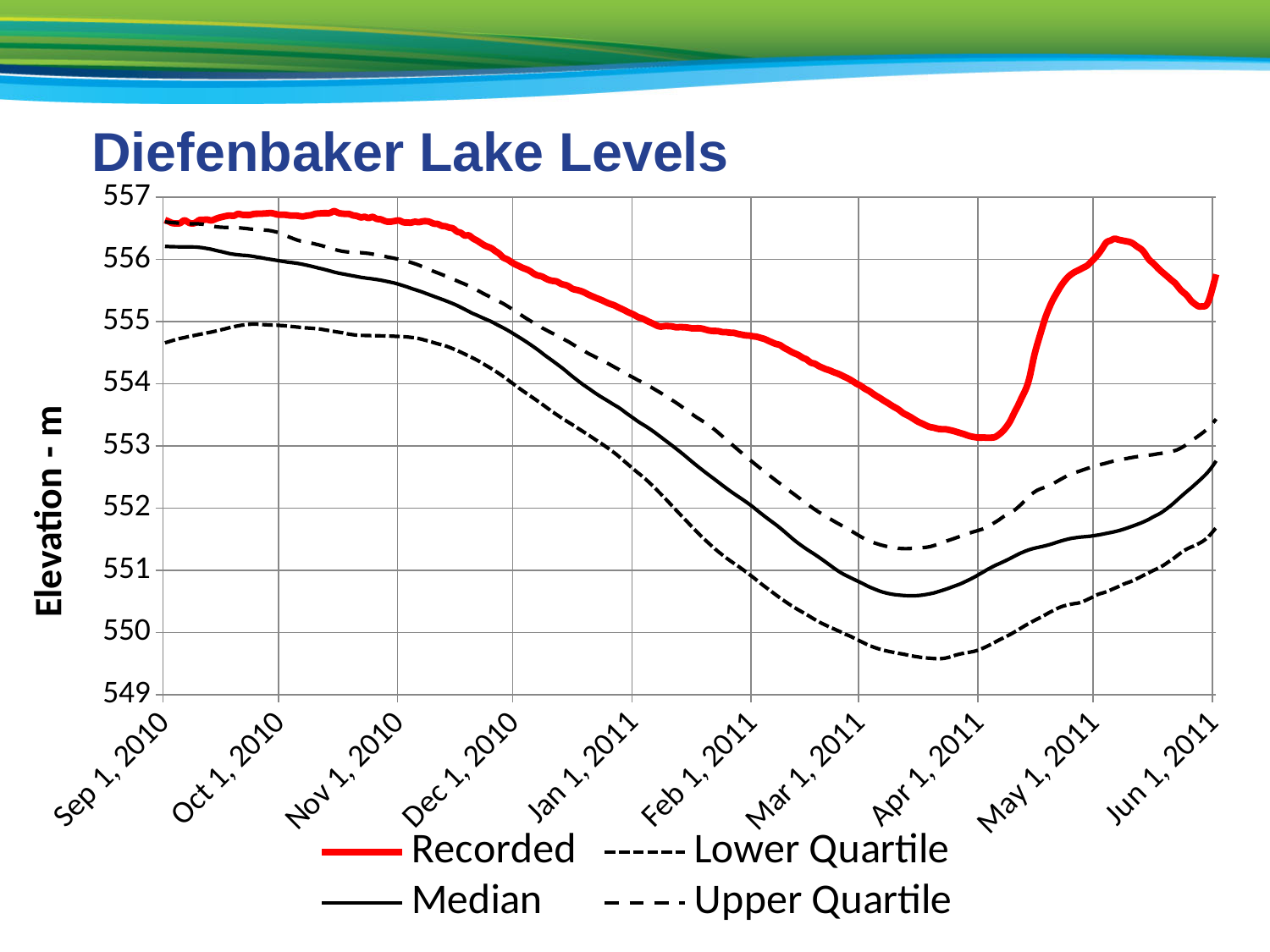
Does the Median line rise or fall from Sep 1, 2010 to Apr 1, 2011? fall What is the label on the vertical axis? Elevation - m What kind of chart is shown on the slide? line chart Is the Lower Quartile value at Apr 1, 2011 greater or less than 550? less What is the title of the chart? Diefenbaker Lake Levels How many date labels are shown on the x axis? 10 How many series does the legend list? 4 Is the Recorded value at Apr 1, 2011 greater or less than 554? less At Mar 1, 2011, which is higher: the Recorded line or the Median line? Recorded Is the Recorded value at Sep 1, 2010 greater or less than 556? greater Does the Recorded line rise or fall from Apr 1, 2011 to May 1, 2011? rise